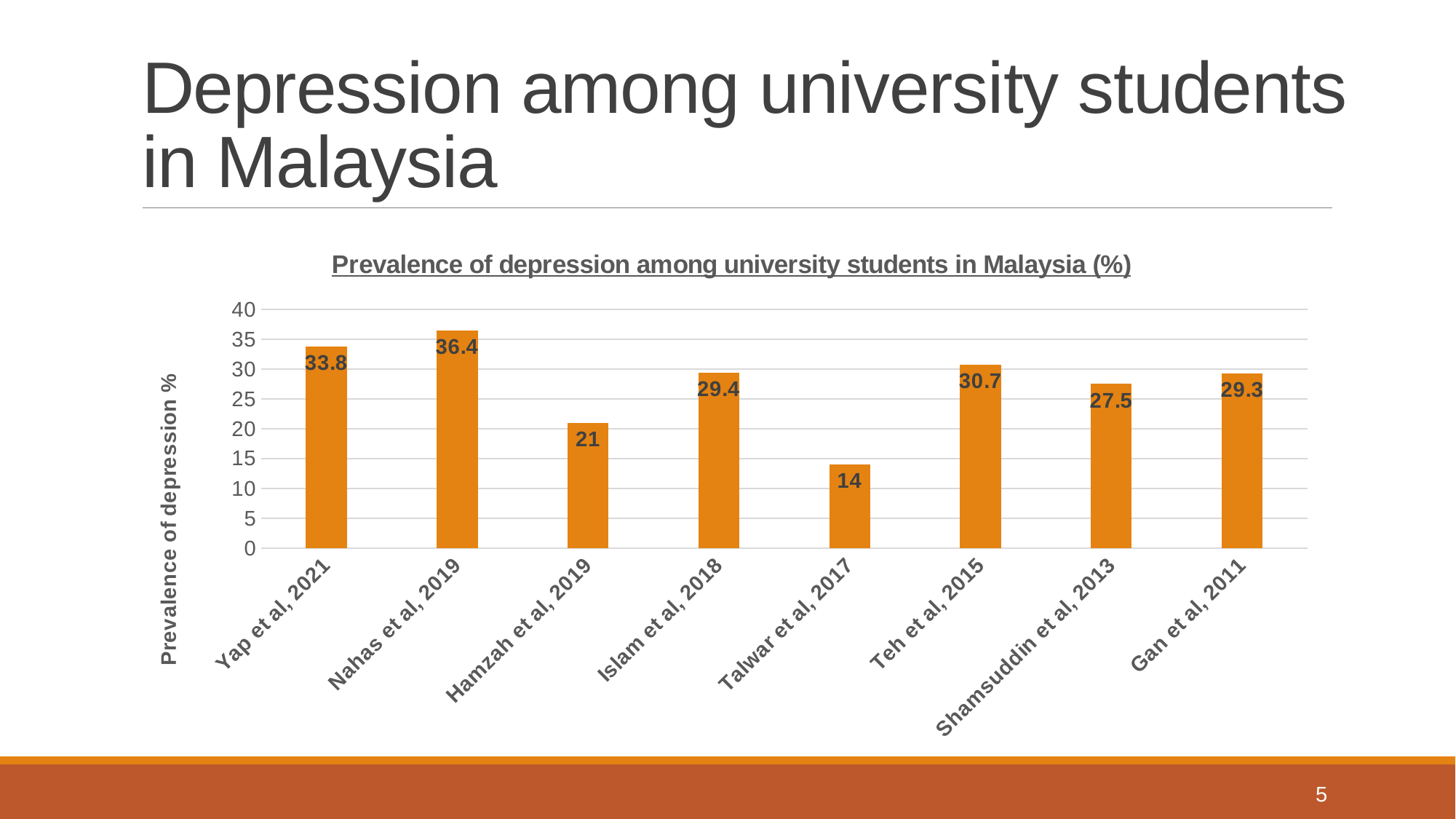
Which study reports the highest prevalence of depression? Nahas et al, 2019 What is the title of the chart? Prevalence of depression among university students in Malaysia (%) Which is larger: the value for Yap et al, 2021 or the value for Teh et al, 2015? Yap et al, 2021 How many studies are shown in the chart? 8 What is the prevalence of depression for Shamsuddin et al, 2013? 27.5 What value is shown for Talwar et al, 2017? 14 What is the label of the vertical axis? Prevalence of depression % Which study reports the lowest prevalence of depression? Talwar et al, 2017 What kind of chart is shown on the slide? Bar chart Is the value for Hamzah et al, 2019 greater or less than 25? less What is the difference between the values for Nahas et al, 2019 and Talwar et al, 2017? 22.4 What is the prevalence of depression reported by Nahas et al, 2019? 36.4